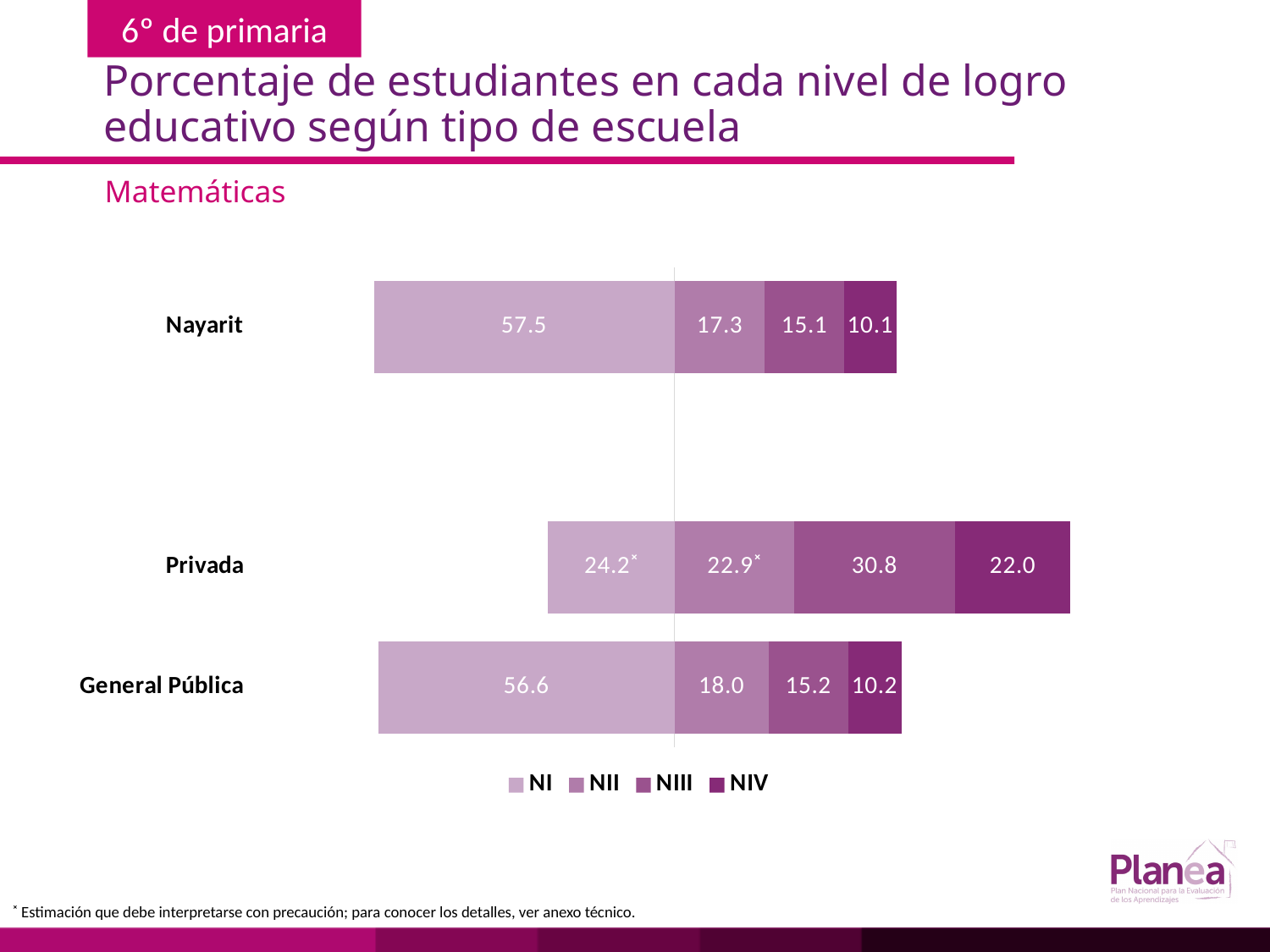
Which school type has the highest NI value? Nayarit What is the NII value for General Pública? 18.0 Which is larger, the NIII value for Privada or the NIII value for General Pública? Privada How many series does the legend list? 4 What is the difference between the NI values for Nayarit and General Pública? 0.9 What percentage of Nayarit students are at level NI? 57.5 What is the NIV value for Privada? 22.0 What is the NIII value for Privada? 30.8 Which school type has the lowest NIV value? Nayarit What is the total of the stacked bar for Privada? 99.9 What kind of chart is shown on the slide? Stacked bar chart How many school types are shown in the chart? 3